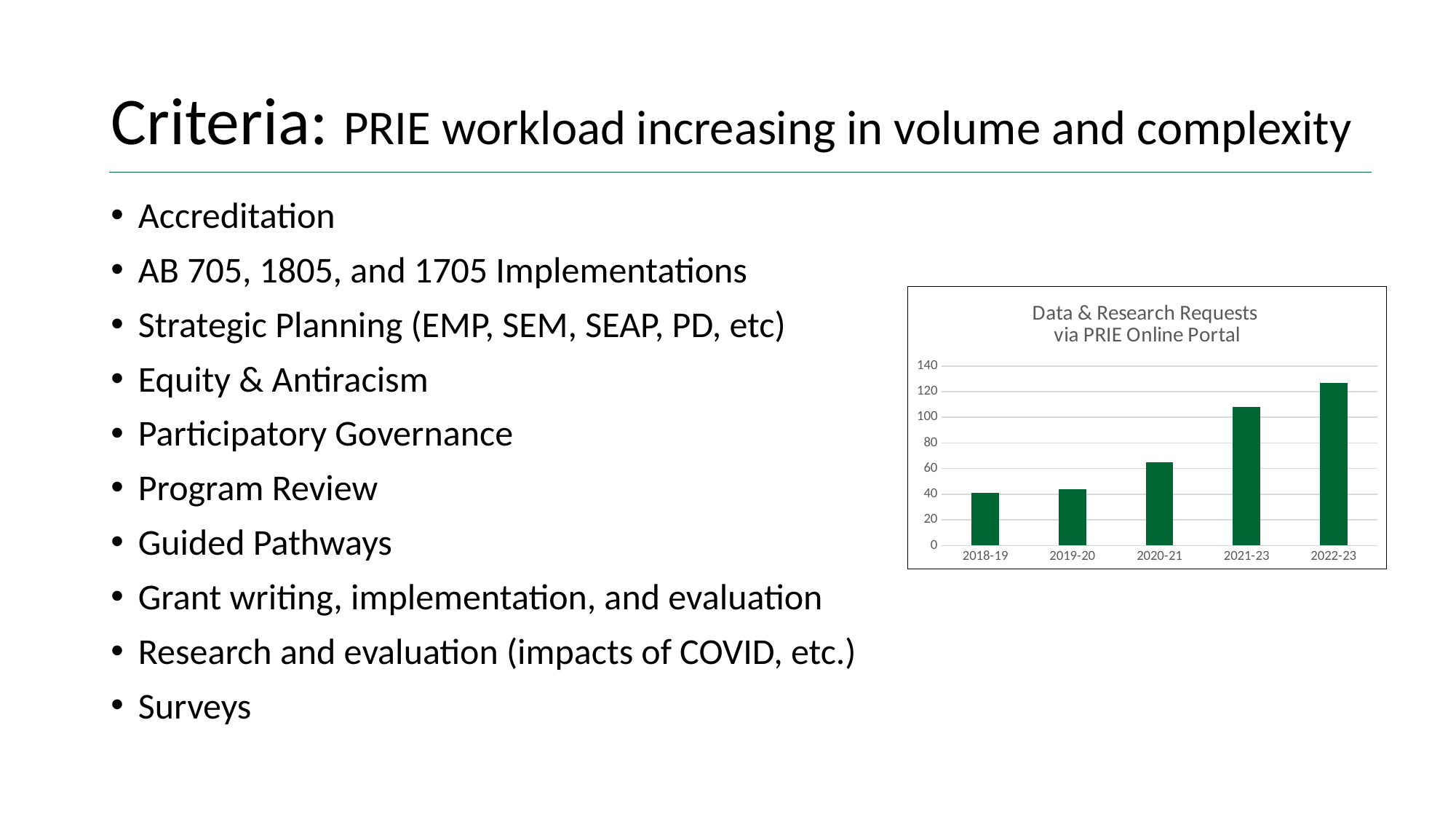
Which year has the highest number of data and research requests? 2022-23 Do the values rise or fall from 2018-19 to 2022-23? rise What is the title of the chart? Data & Research Requests via PRIE Online Portal What kind of chart is shown on the slide? bar chart What is the highest value shown on the chart's vertical axis? 140 Is the value for 2020-21 greater or less than 60? greater Is the value for 2019-20 greater or less than 40? greater Which is larger, the value for 2021-23 or the value for 2020-21? 2021-23 Is the value for 2022-23 greater or less than 120? greater How many academic years are shown on the x axis of the chart? 5